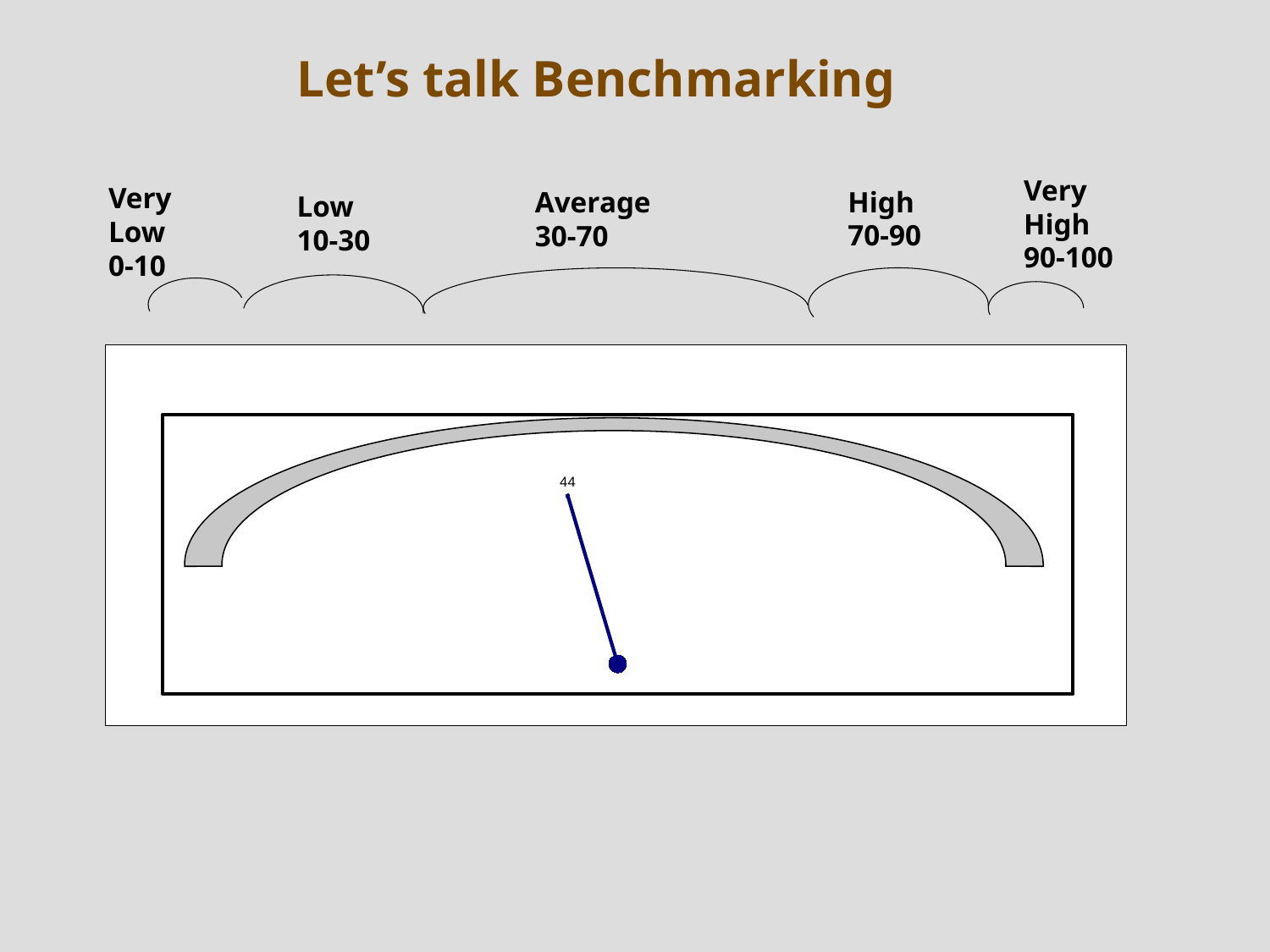
What kind of chart is shown on the slide? gauge chart How many labelled bands are shown above the gauge? 5 What range of values does the Very Low band cover? 0-10 What value does the needle on the gauge point to? 44 What colour is the needle on the gauge? dark blue What range of values does the Average band cover? 30-70 Is the value shown by the needle greater or less than 70? less Which labelled band does the needle value of 44 fall into? Average Is the value shown by the needle greater or less than 30? greater What is the title of the slide containing the gauge? Let's talk Benchmarking What range of values does the High band cover? 70-90